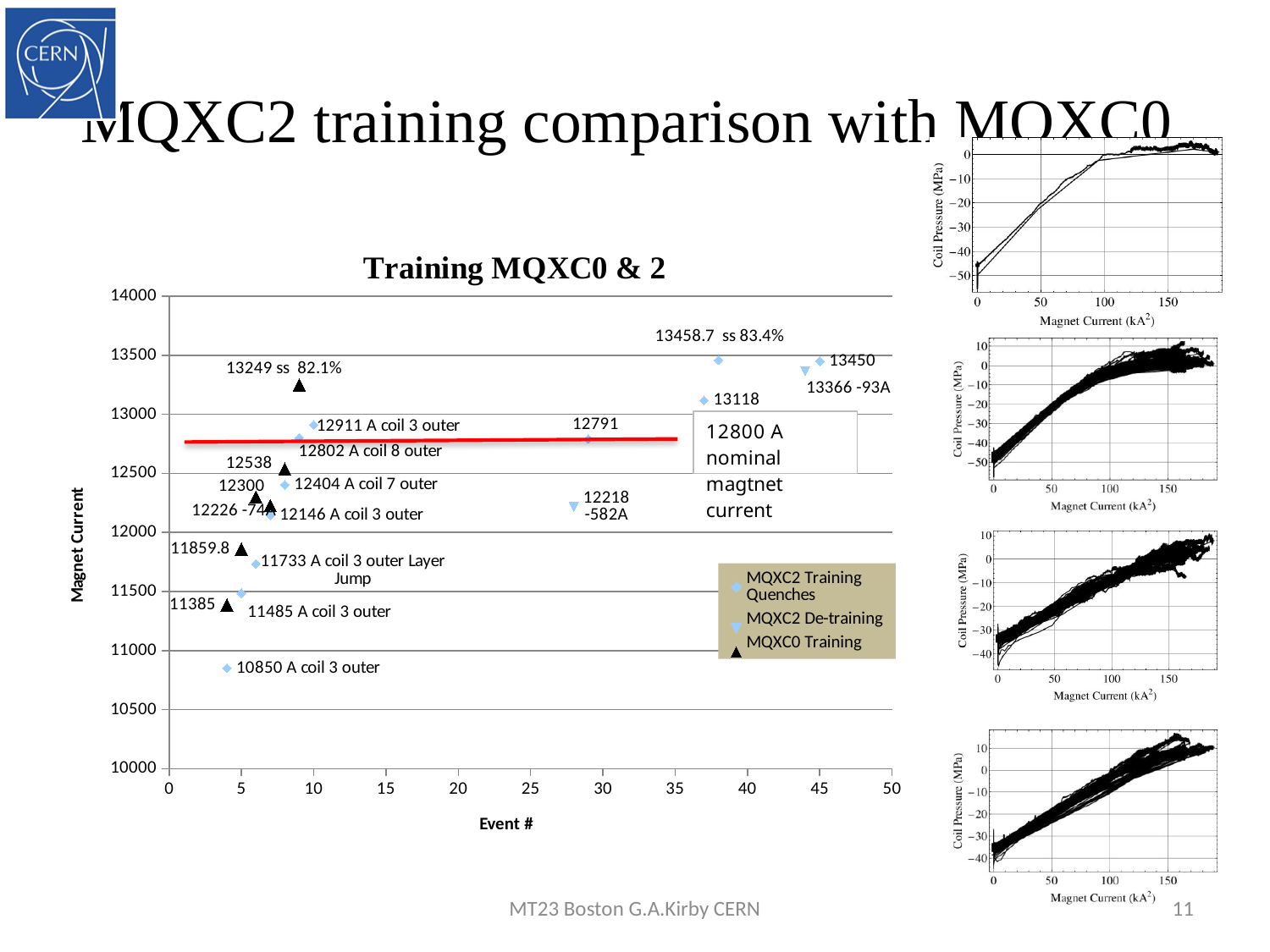
In the 'Training MQXC0 & 2' chart, do the MQXC2 training quench currents generally rise or fall as the event number increases? rise In the 'Training MQXC0 & 2' chart, which is larger: the MQXC2 quench labelled '12911 A coil 3 outer' or the MQXC0 quench labelled '12538'? 12911 A coil 3 outer How many series does the legend of the 'Training MQXC0 & 2' chart list? 3 In the 'Training MQXC0 & 2' chart, what is the highest labelled MQXC2 training quench current? 13458.7 In the 'Training MQXC0 & 2' chart, is the first MQXC2 training quench (10850 A) greater or less than 11000? less What are the three series named in the legend of the 'Training MQXC0 & 2' chart? MQXC2 Training Quenches, MQXC2 De-training, MQXC0 Training In the 'Training MQXC0 & 2' chart, what is the labelled current of the MQXC2 de-training point near event 28? 12218 What kind of chart is 'Training MQXC0 & 2'? scatter chart In the 'Training MQXC0 & 2' chart, what nominal magnet current does the red line mark? 12800 A In the 'Training MQXC0 & 2' chart, what is the highest labelled MQXC0 training quench current? 13249 In the 'Training MQXC0 & 2' chart, what is the magnet current of the first MQXC2 training quench, labelled 'coil 3 outer'? 10850 A In the 'Training MQXC0 & 2' chart, what is the difference between the highest MQXC2 quench (13458.7) and the highest MQXC0 quench (13249)? 209.7